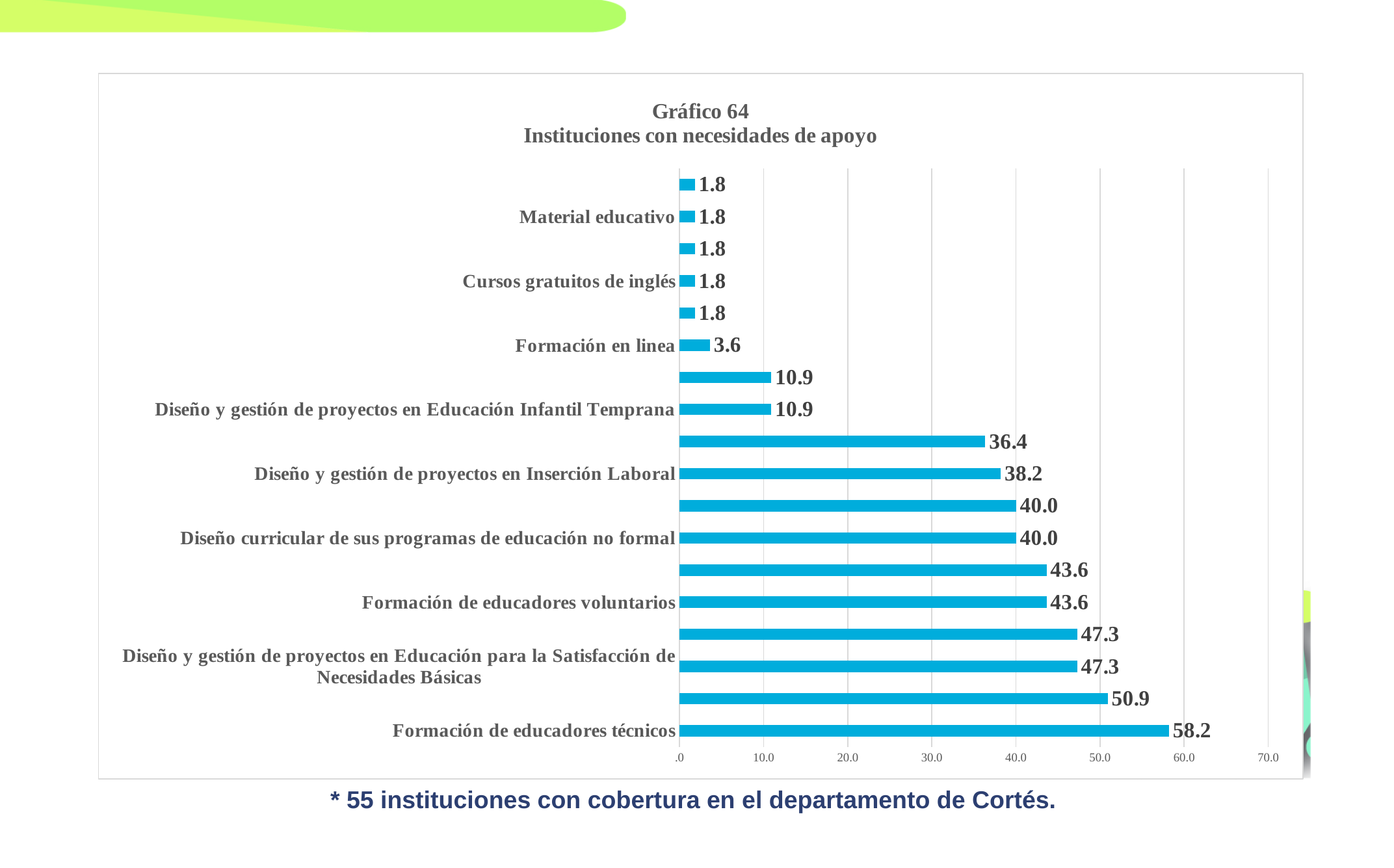
What is the title of the chart? Gráfico 64 Instituciones con necesidades de apoyo What is the value for Diseño y gestión de proyectos en Educación Infantil Temprana? 10.9 What is the value for Formación en linea? 3.6 What is the value for Diseño y gestión de proyectos en Inserción Laboral? 38.2 What is the lowest value shown on the chart? 1.8 What is the difference between Formación de educadores técnicos and Formación de educadores voluntarios? 14.6 Which labelled category has the highest value? Formación de educadores técnicos What is the value for Formación de educadores técnicos? 58.2 Which is larger: Diseño curricular de sus programas de educación no formal or Diseño y gestión de proyectos en Inserción Laboral? Diseño curricular de sus programas de educación no formal How many bars are plotted on the chart? 18 What type of chart is shown on the slide? bar chart What is the value for Formación de educadores voluntarios? 43.6